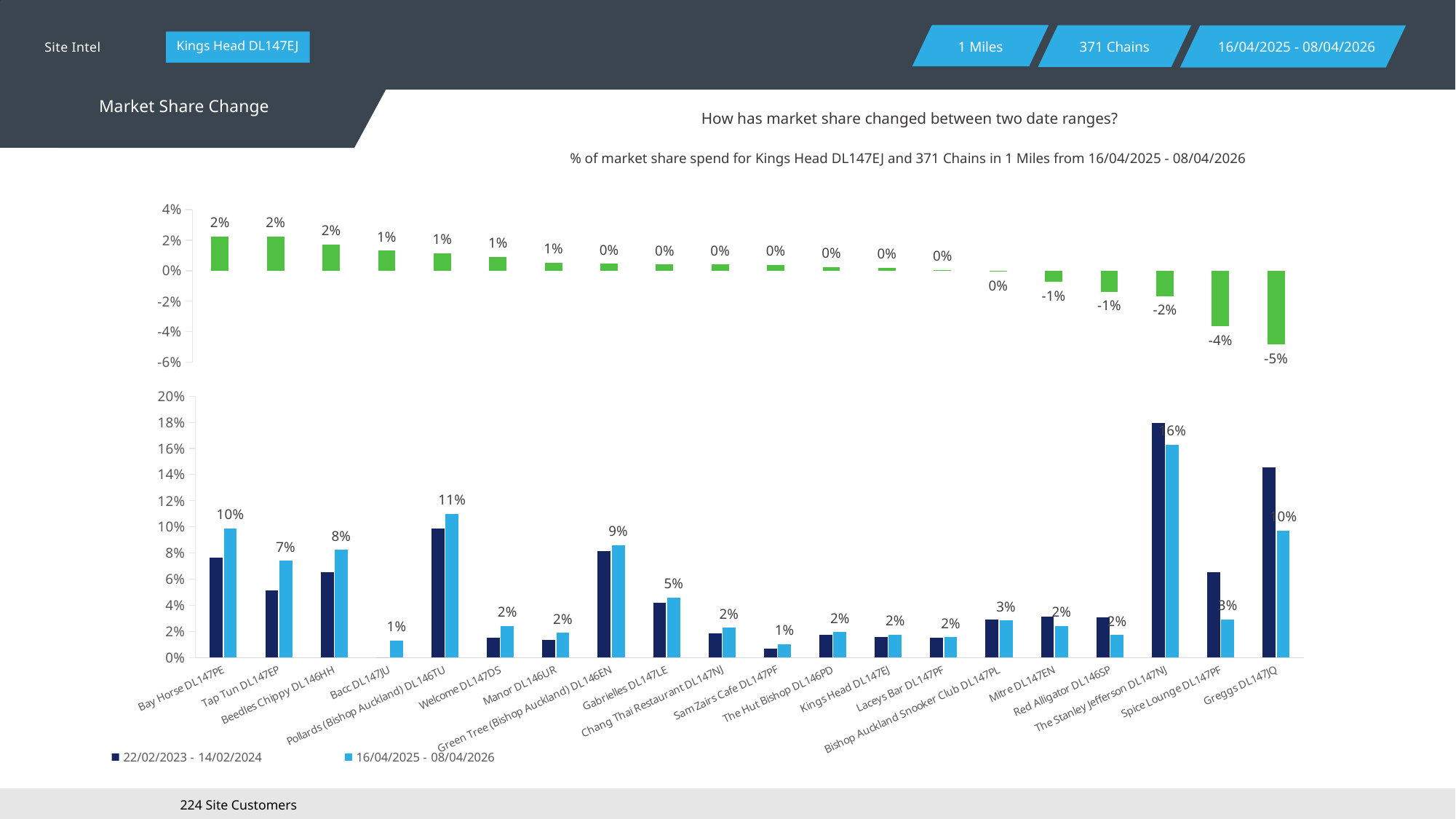
In the top chart (market share change), which category has the lowest value? Greggs DL147JQ In the top chart (market share change), what is the value for Greggs DL147JQ? -5% How many categories are shown on the x axis of the bottom chart? 20 How many series does the legend of the bottom chart list? 2 In the bottom chart, which has the larger 16/04/2025 - 08/04/2026 value, Bay Horse DL147PE or Beedles Chippy DL146HH? Bay Horse DL147PE In the bottom chart, what is the difference between the 16/04/2025 - 08/04/2026 values for Bay Horse DL147PE and Tap Tun DL147EP? 3% What kind of chart is the bottom chart? bar chart In the bottom chart, which category has the highest 16/04/2025 - 08/04/2026 value? The Stanley Jefferson DL147NJ In the bottom chart, what is the 16/04/2025 - 08/04/2026 value for Pollards (Bishop Auckland) DL146TU? 11% In the top chart (market share change), what is the value for Bay Horse DL147PE? 2% In the bottom chart, is the 22/02/2023 - 14/02/2024 value for The Stanley Jefferson DL147NJ greater or less than 16%? greater In the top chart (market share change), what is the value for Spice Lounge DL147PF? -4%